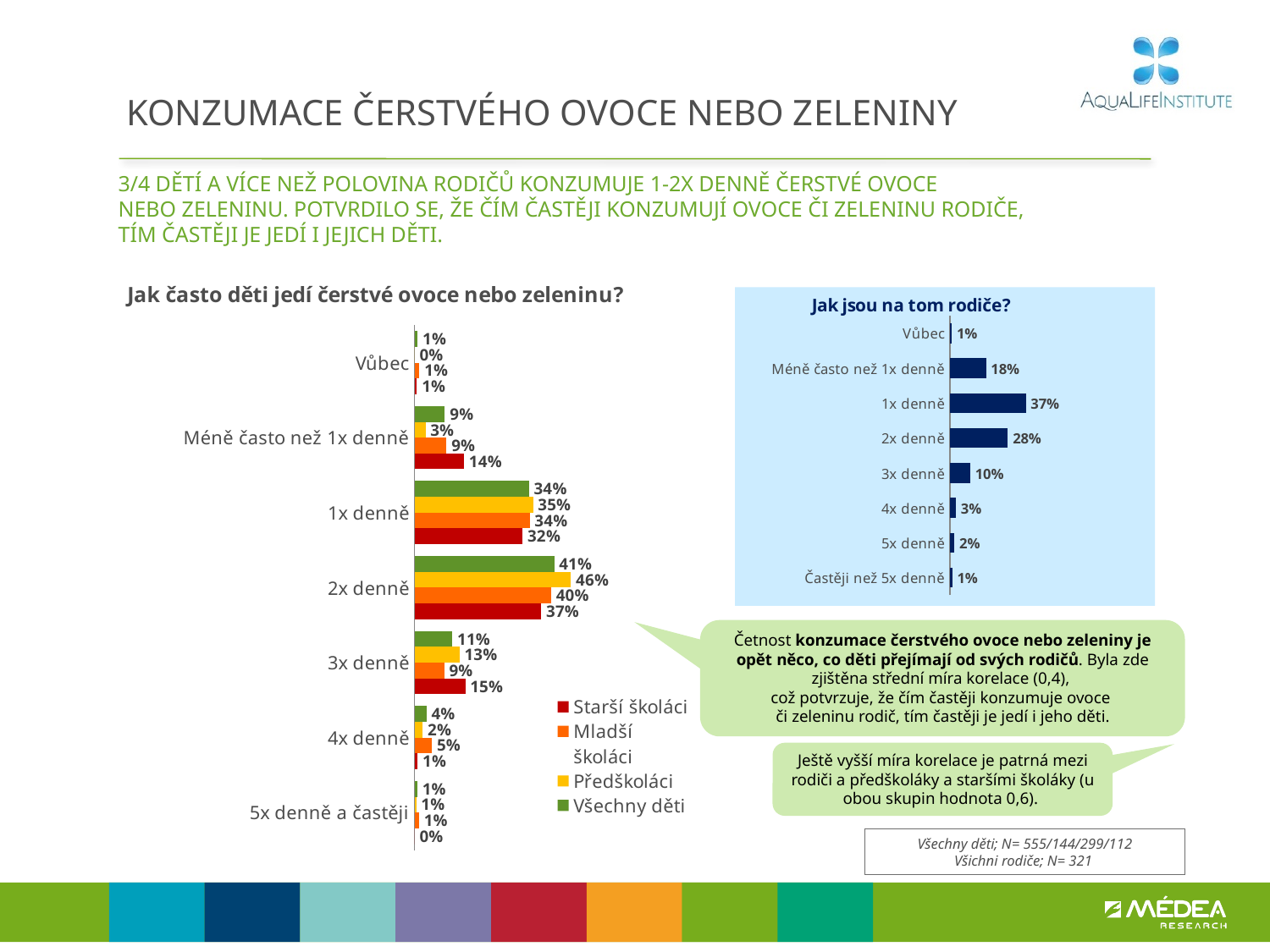
In the chart 'Jak často děti jedí čerstvé ovoce nebo zeleninu?', how many series does the legend list? 4 In the chart 'Jak často děti jedí čerstvé ovoce nebo zeleninu?', which is larger at '3x denně': 'Starší školáci' or 'Mladší školáci'? Starší školáci In the chart 'Jak jsou na tom rodiče?', what is the value for 'Méně často než 1x denně'? 18% In the chart 'Jak jsou na tom rodiče?', what is the difference between '1x denně' and '2x denně'? 9% In the chart 'Jak jsou na tom rodiče?', how many categories are shown? 8 In the chart 'Jak často děti jedí čerstvé ovoce nebo zeleninu?', which colour represents 'Všechny děti'? Green In the chart 'Jak jsou na tom rodiče?', which category has the highest value? 1x denně What type of chart is 'Jak jsou na tom rodiče?'? Bar chart In the chart 'Jak často děti jedí čerstvé ovoce nebo zeleninu?', what is the value for 'Starší školáci' at 'Méně často než 1x denně'? 14% In the chart 'Jak často děti jedí čerstvé ovoce nebo zeleninu?', what is the value for 'Předškoláci' at '2x denně'? 46% In the chart 'Jak jsou na tom rodiče?', what is the value for '1x denně'? 37% In the chart 'Jak často děti jedí čerstvé ovoce nebo zeleninu?', what is the difference between 'Předškoláci' and 'Starší školáci' at '2x denně'? 9%